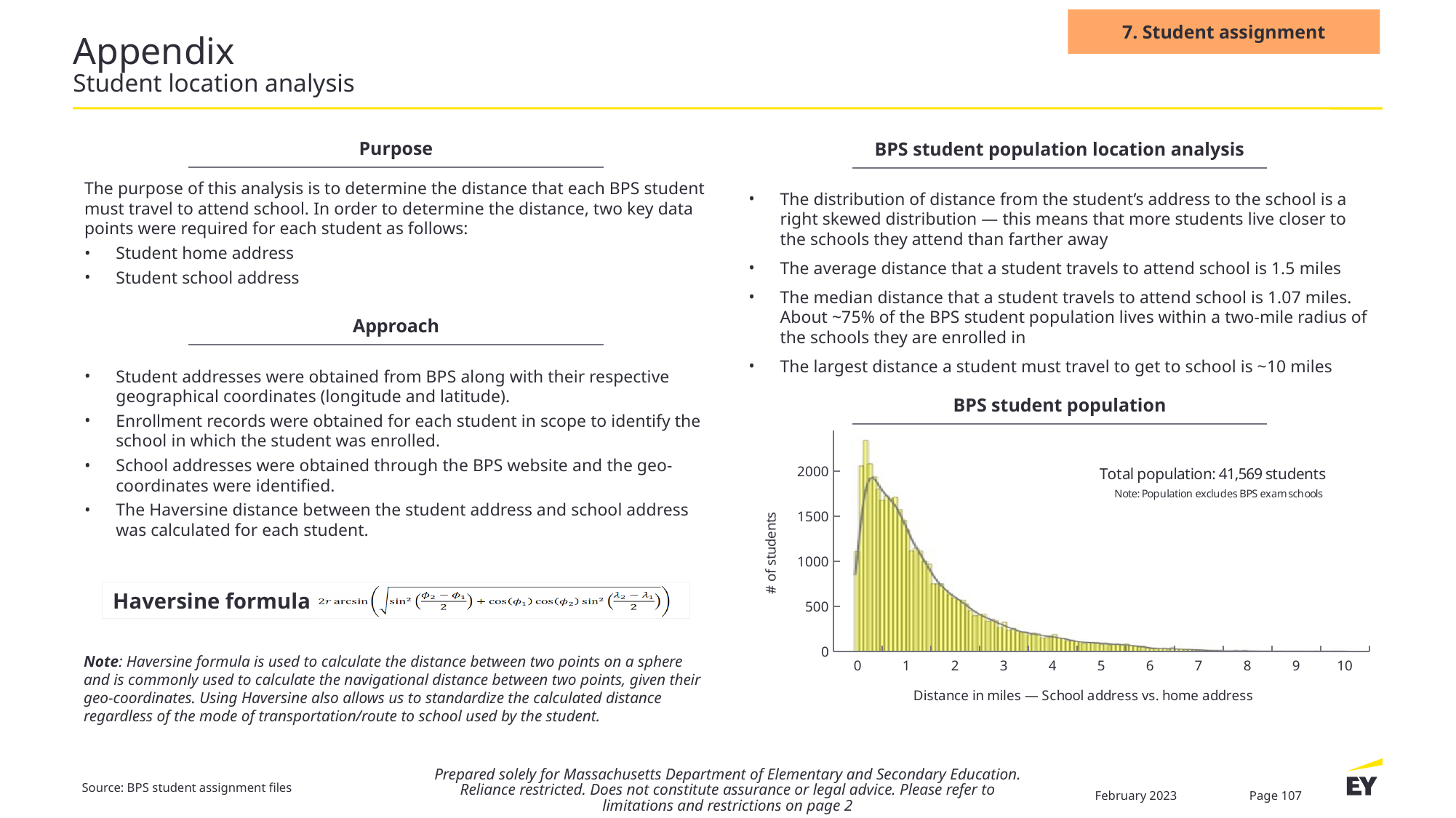
What total population is stated on the "BPS student population" chart? 41,569 students In the "BPS student population" chart, is the number of students at a distance of 5 miles greater or less than 500? less How many tick labels are shown on the x axis of the "BPS student population" chart? 11 In the "BPS student population" chart, is the tallest bar greater or less than 2000 students? greater What is the title of the chart on the slide? BPS student population What kind of chart is the "BPS student population" chart? Bar chart (histogram) In the "BPS student population" chart, which is larger: the number of students at about 1 mile or at about 4 miles? about 1 mile What is the x-axis label of the "BPS student population" chart? Distance in miles — School address vs. home address In the "BPS student population" chart, do the bars generally rise or fall as distance increases beyond 1 mile? fall What is the highest value shown on the x axis of the "BPS student population" chart? 10 In the "BPS student population" chart, is the number of students at a distance of 3 miles greater or less than 1000? less In the "BPS student population" chart, between which two x-axis ticks does the tallest bar fall? Between 0 and 1 miles